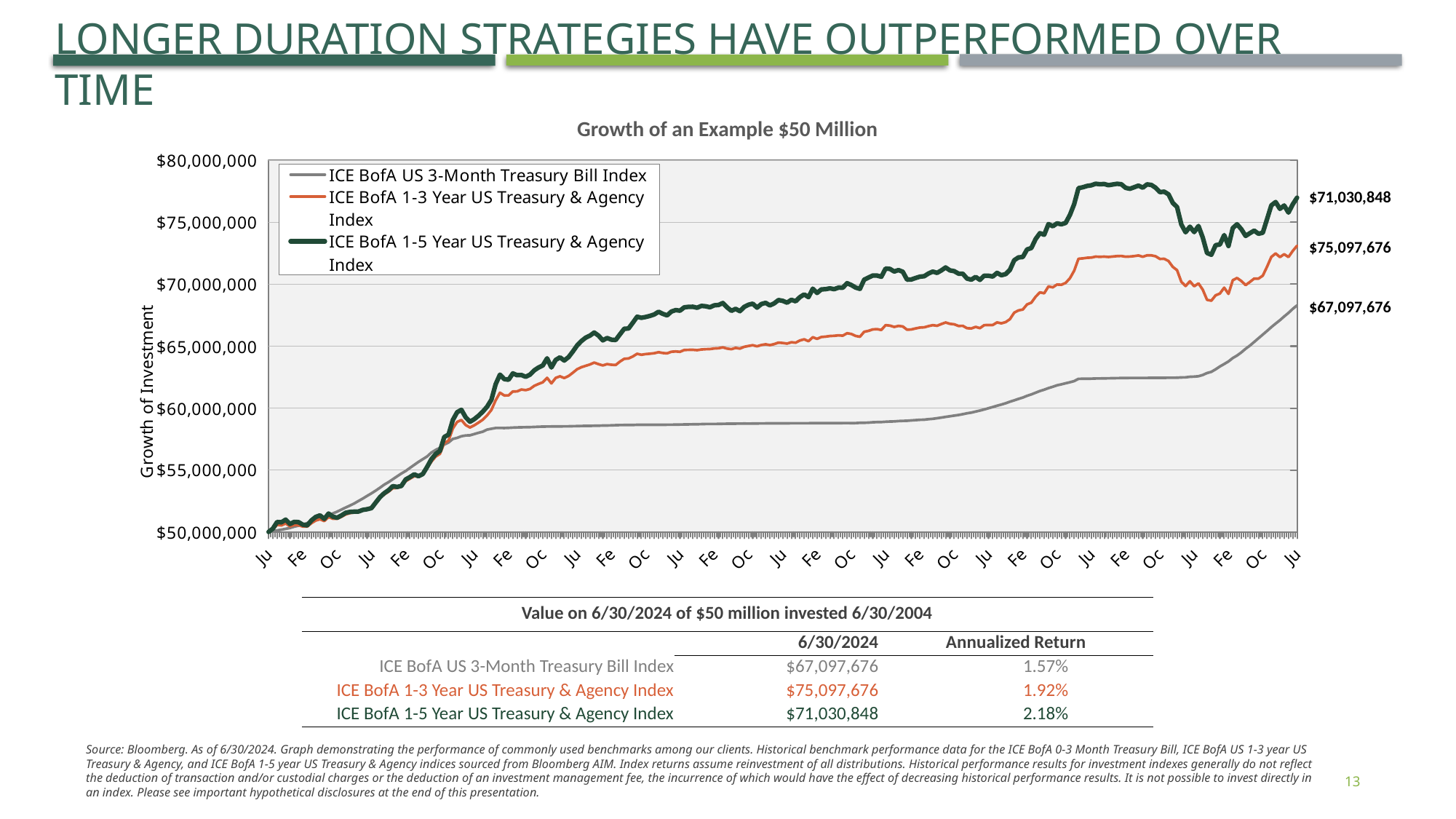
What is the ending value labelled for the ICE BofA 1-3 Year US Treasury & Agency Index? $75,097,676 What is the difference between the ending values of the ICE BofA 1-5 Year US Treasury & Agency Index and the ICE BofA US 3-Month Treasury Bill Index? $3,933,172 What is the ending value labelled for the ICE BofA US 3-Month Treasury Bill Index? $67,097,676 Which series has the lowest ending value on the chart? ICE BofA US 3-Month Treasury Bill Index What is the title of the chart? Growth of an Example $50 Million What kind of chart is shown on the slide? line chart What is the ending value labelled for the ICE BofA 1-5 Year US Treasury & Agency Index? $71,030,848 Do the series values generally rise or fall from left to right along the x axis? rise Is the ending value of the ICE BofA US 3-Month Treasury Bill Index greater or less than $65,000,000? greater How many series does the chart legend list? 3 Which has the larger ending value, the ICE BofA 1-3 Year US Treasury & Agency Index or the ICE BofA US 3-Month Treasury Bill Index? ICE BofA 1-3 Year US Treasury & Agency Index What is the difference between the ending values of the ICE BofA 1-3 Year US Treasury & Agency Index and the ICE BofA US 3-Month Treasury Bill Index? $8,000,000